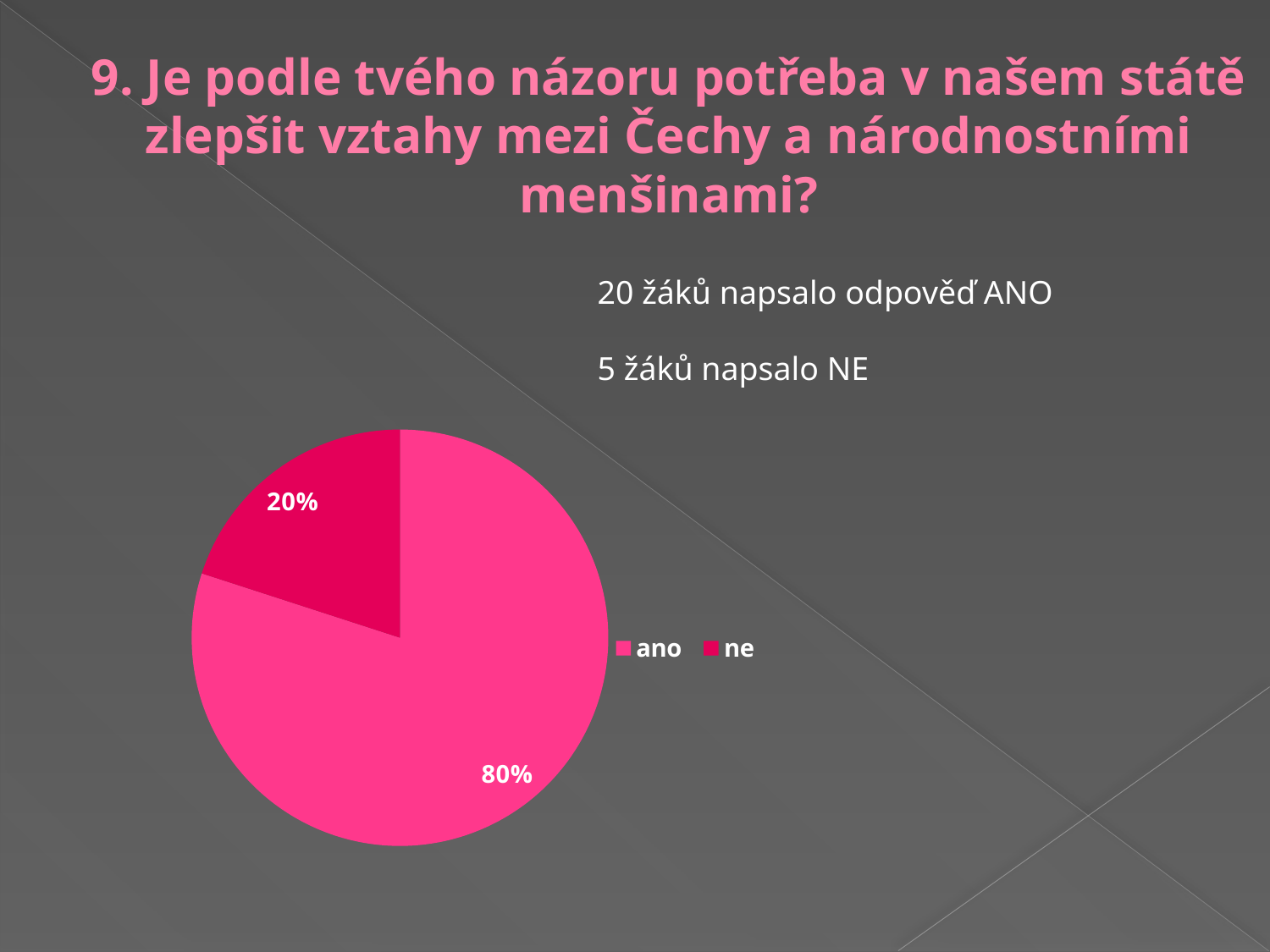
Which is larger, the "ano" slice or the "ne" slice? ano What share of the pie does the "ne" slice represent? 20% Which slice of the pie is the largest? ano Which legend entry is shown in the darker pink colour? ne How many entries does the legend list? 2 What share of the pie does the "ano" slice represent? 80% What kind of chart is shown on the slide? pie chart Which slice of the pie is the smallest? ne What is the difference in percentage points between the "ano" and "ne" slices? 60 What are the two legend entries of the pie chart? ano, ne How many slices does the pie chart have? 2